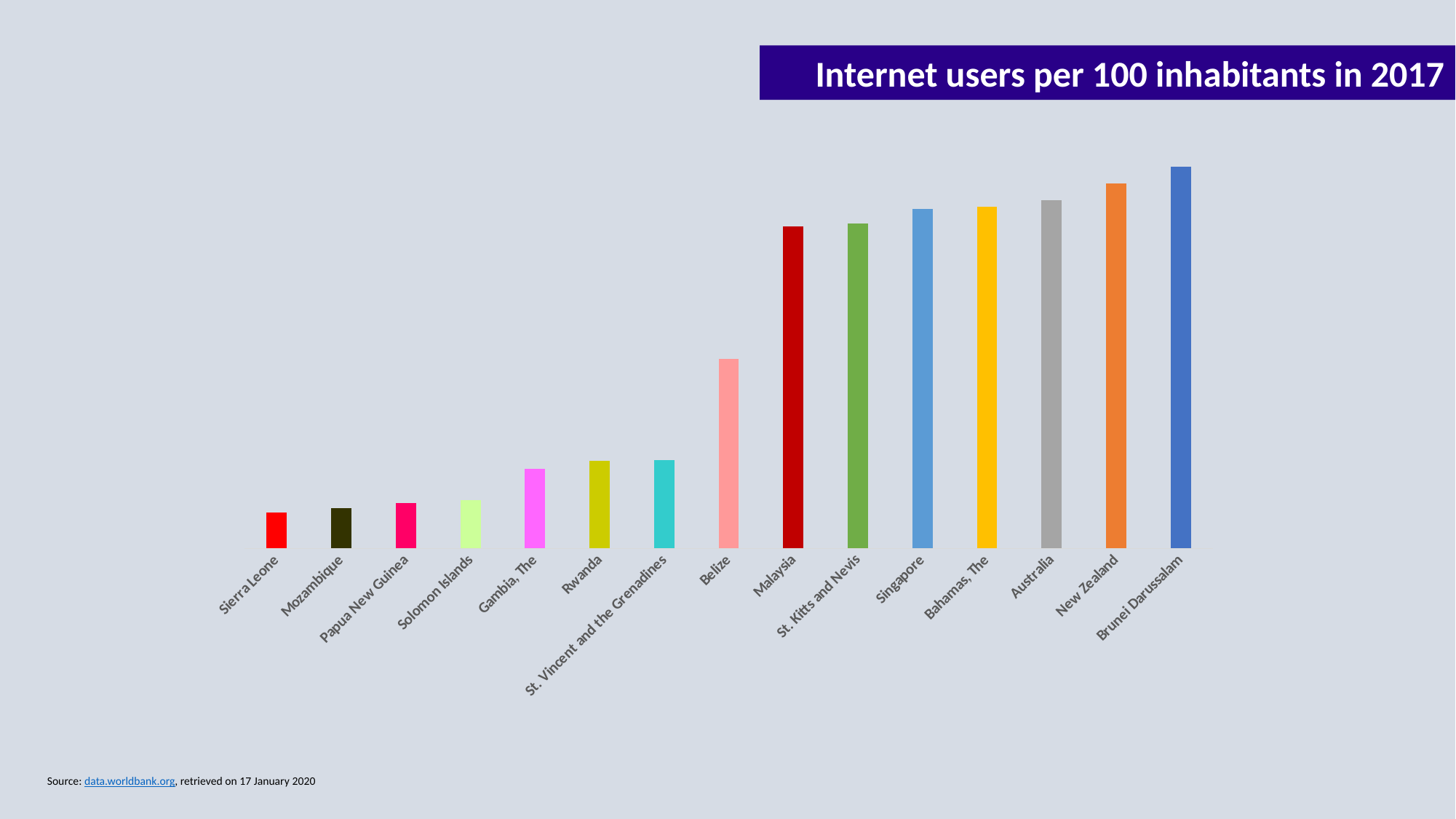
Which has the larger value, Australia or Singapore? Australia Which has the larger value, New Zealand or Bahamas, The? New Zealand Which has the larger value, Belize or St. Vincent and the Grenadines? Belize Do the values rise or fall from left to right across the chart? rise What kind of chart is shown on the slide? bar chart Which country has the highest number of internet users per 100 inhabitants? Brunei Darussalam What is the title of the chart? Internet users per 100 inhabitants in 2017 Which country is shown with the leftmost bar? Sierra Leone How many countries are shown in the chart? 15